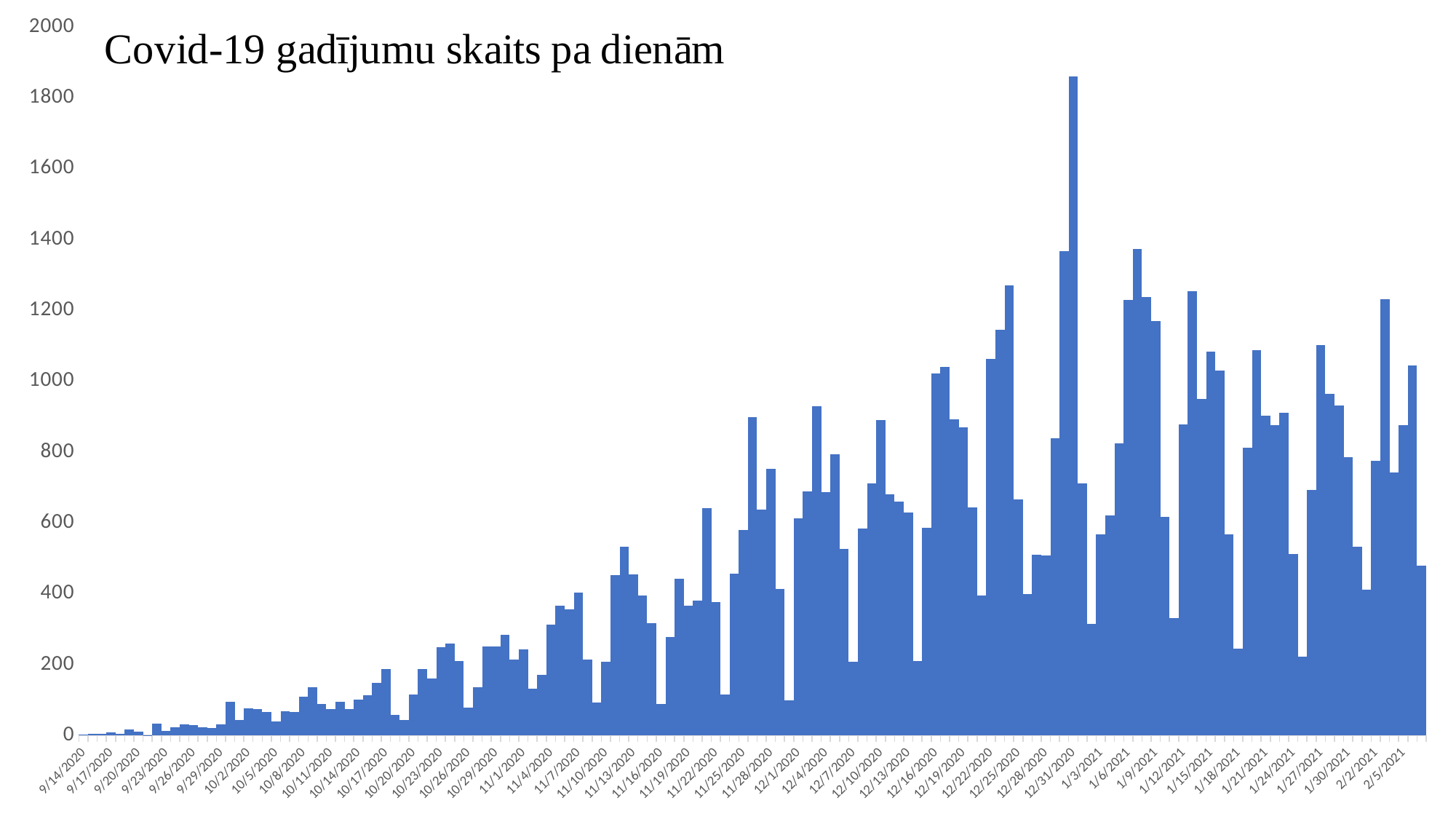
Is the value for 11/25/2020 greater or less than 800? less What kind of chart is shown on the slide? bar chart Is the tallest bar in the chart greater or less than 1800? greater What is the highest value shown on the vertical axis? 2000 Is the value for 1/15/2021 greater or less than 800? greater Overall, do the daily case counts rise or fall from September 2020 to January 2021? rise Which is larger, the value for 9/14/2020 or the value for 1/6/2021? 1/6/2021 What is the title of the chart? Covid-19 gadījumu skaits pa dienām